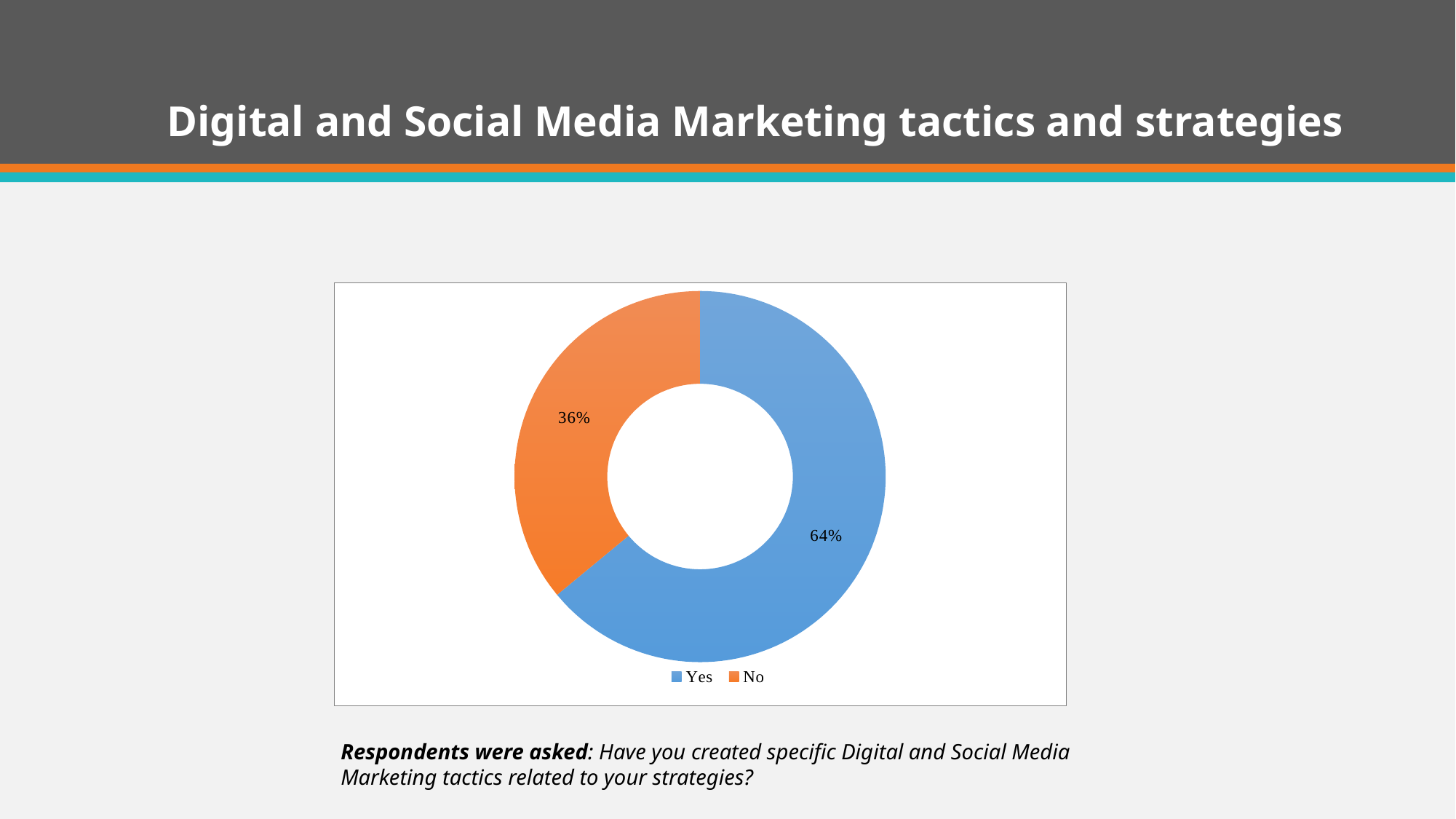
What is the difference in percentage points between the Yes and No shares? 28 Which response has the larger share of the chart? Yes Is the share for Yes larger or smaller than the share for No? larger Which response has the smaller share of the chart? No What colour is the No segment? orange What percentage of respondents answered No? 36% What is the combined share of the Yes and No segments? 100% What kind of chart is shown on the slide? doughnut (pie) chart What percentage of respondents answered Yes? 64% What colour is the Yes segment? blue How many categories does the chart show? 2 How many entries does the legend list? 2